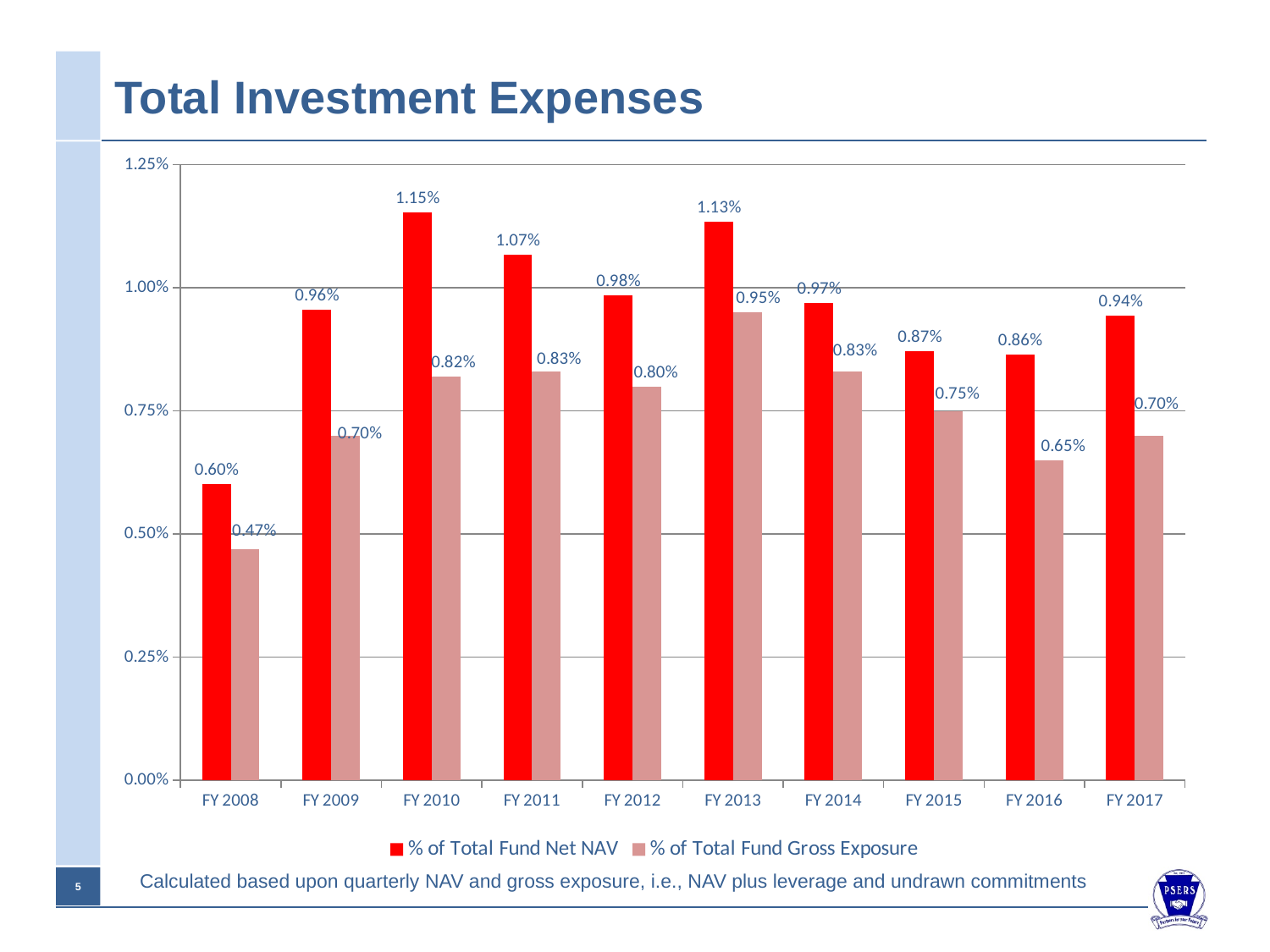
What is the title of the chart? Total Investment Expenses Which is larger: the % of Total Fund Net NAV in FY 2011 or in FY 2014? FY 2011 How many fiscal years are shown on the x axis? 10 How many series does the legend list? 2 What kind of chart is shown on the slide? Bar chart Does the % of Total Fund Net NAV rise or fall from FY 2013 to FY 2016? Fall Which fiscal year has the highest % of Total Fund Net NAV? FY 2010 What is the % of Total Fund Gross Exposure for FY 2016? 0.65% Is the % of Total Fund Gross Exposure for FY 2009 greater or less than 0.75%? less What is the difference between the % of Total Fund Net NAV and the % of Total Fund Gross Exposure in FY 2013? 0.18% What is the % of Total Fund Net NAV for FY 2010? 1.15% Which fiscal year has the lowest % of Total Fund Gross Exposure? FY 2008